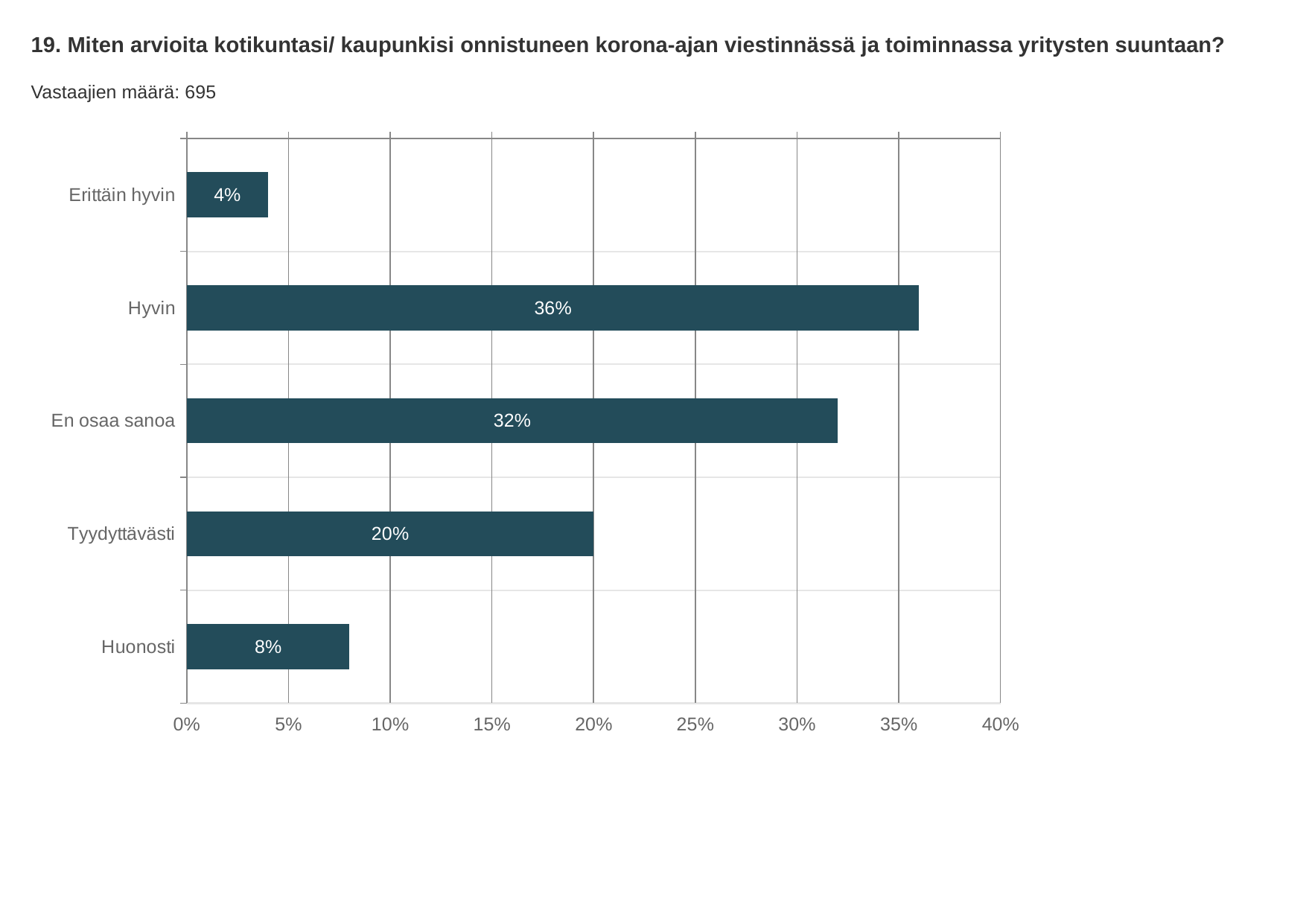
Which category has the highest value? Hyvin How many categories are shown in the chart? 5 What percentage of respondents answered "Hyvin"? 36% What is the difference between the values for "Tyydyttävästi" and "Huonosti"? 12% What is the value shown for "En osaa sanoa"? 32% Which is larger, the value for "Tyydyttävästi" or the value for "Huonosti"? Tyydyttävästi What kind of chart is shown on the slide? Bar chart What is the value shown for "Huonosti"? 8% Which category has the lowest value? Erittäin hyvin How many respondents (Vastaajien määrä) are reported on the slide? 695 What is the difference between the values for "Hyvin" and "En osaa sanoa"? 4% Is the value for "En osaa sanoa" greater or less than 30%? greater